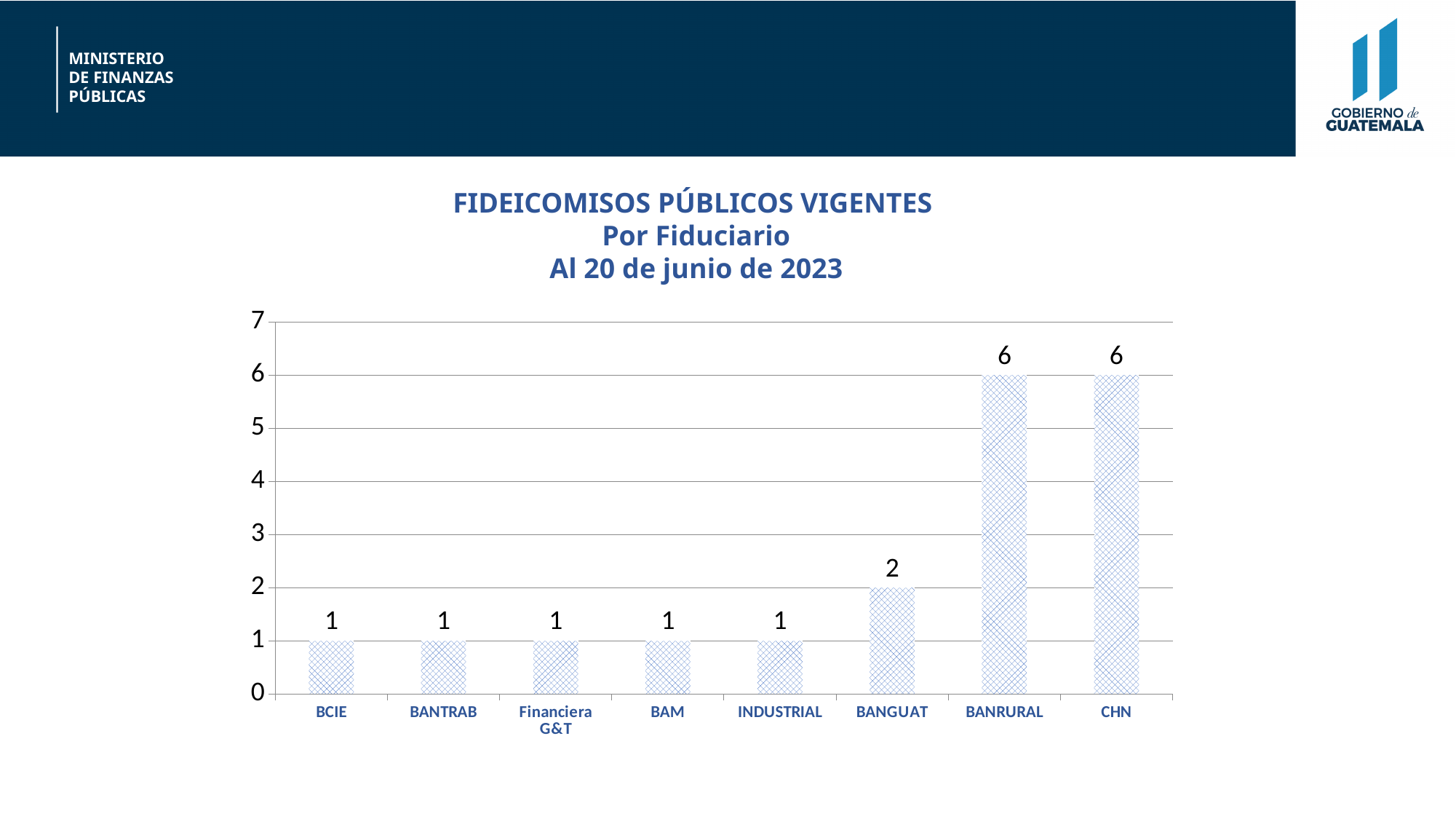
Which is larger, the value for BANGUAT or the value for BAM? BANGUAT Is the value for CHN greater or less than 4? greater What is the value for Financiera G&T? 1 Which categories have the highest value? BANRURAL and CHN What is the difference between the values for BANRURAL and BANGUAT? 4 How many categories are shown on the x axis? 8 What kind of chart is shown on the slide? bar chart What is the value for BANRURAL? 6 How many categories have a value of 1? 5 What is the value for BANGUAT? 2 What is the value for CHN? 6 What is the date given in the chart title? 20 de junio de 2023